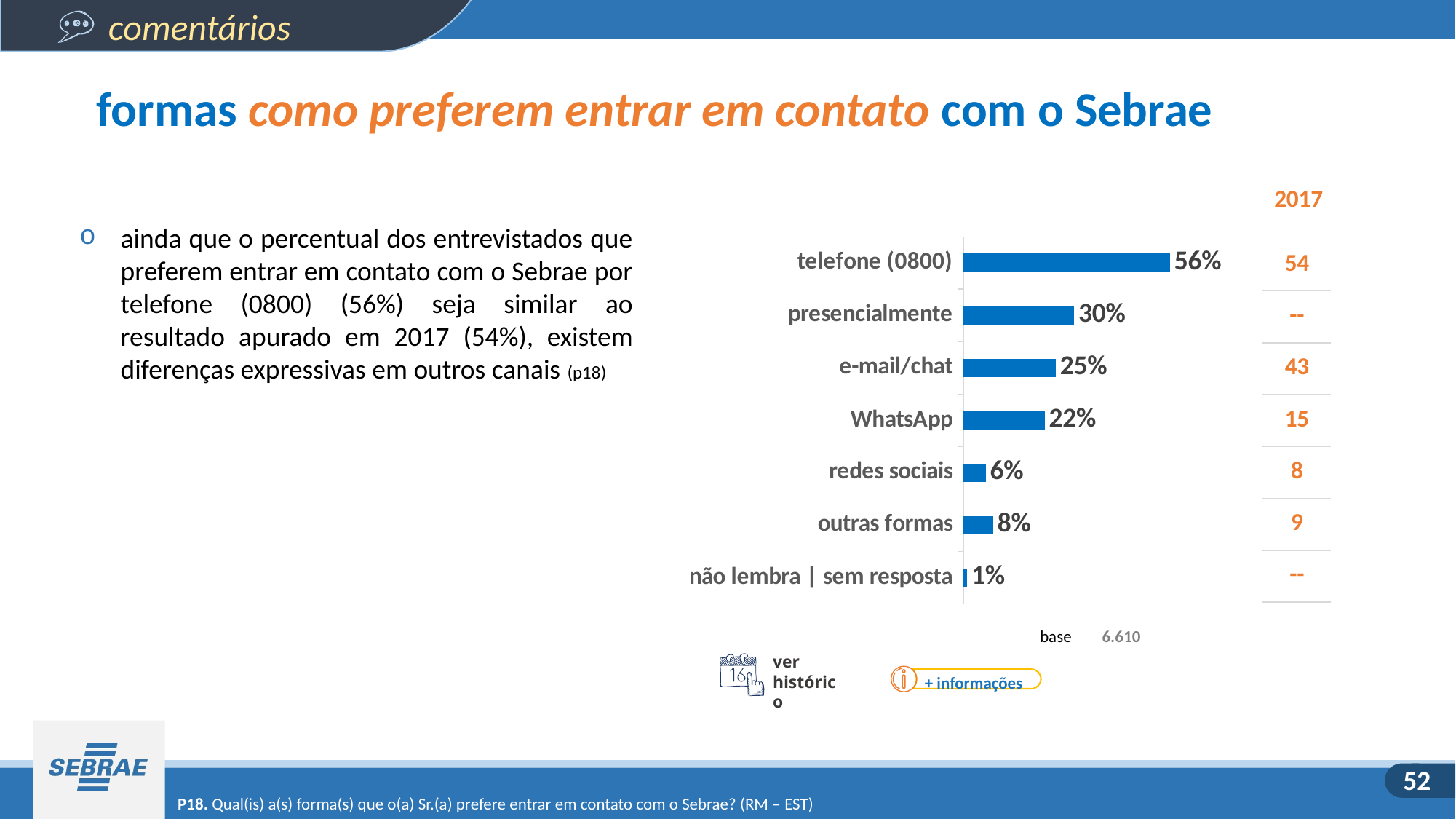
What is the value for telefone (0800)? 56% What kind of chart is shown? bar chart What is the difference between the values for e-mail/chat and WhatsApp? 3% What is the 2017 value shown next to e-mail/chat? 43 Which category has the highest value? telefone (0800) Which is larger, the value for outras formas or the value for redes sociais? outras formas What is the value for redes sociais? 6% How many categories are shown in the chart? 7 What is the difference between the values for telefone (0800) and presencialmente? 26% What is the value for WhatsApp? 22% Which category has the lowest value? não lembra | sem resposta What is the base (number of respondents) shown below the chart? 6.610